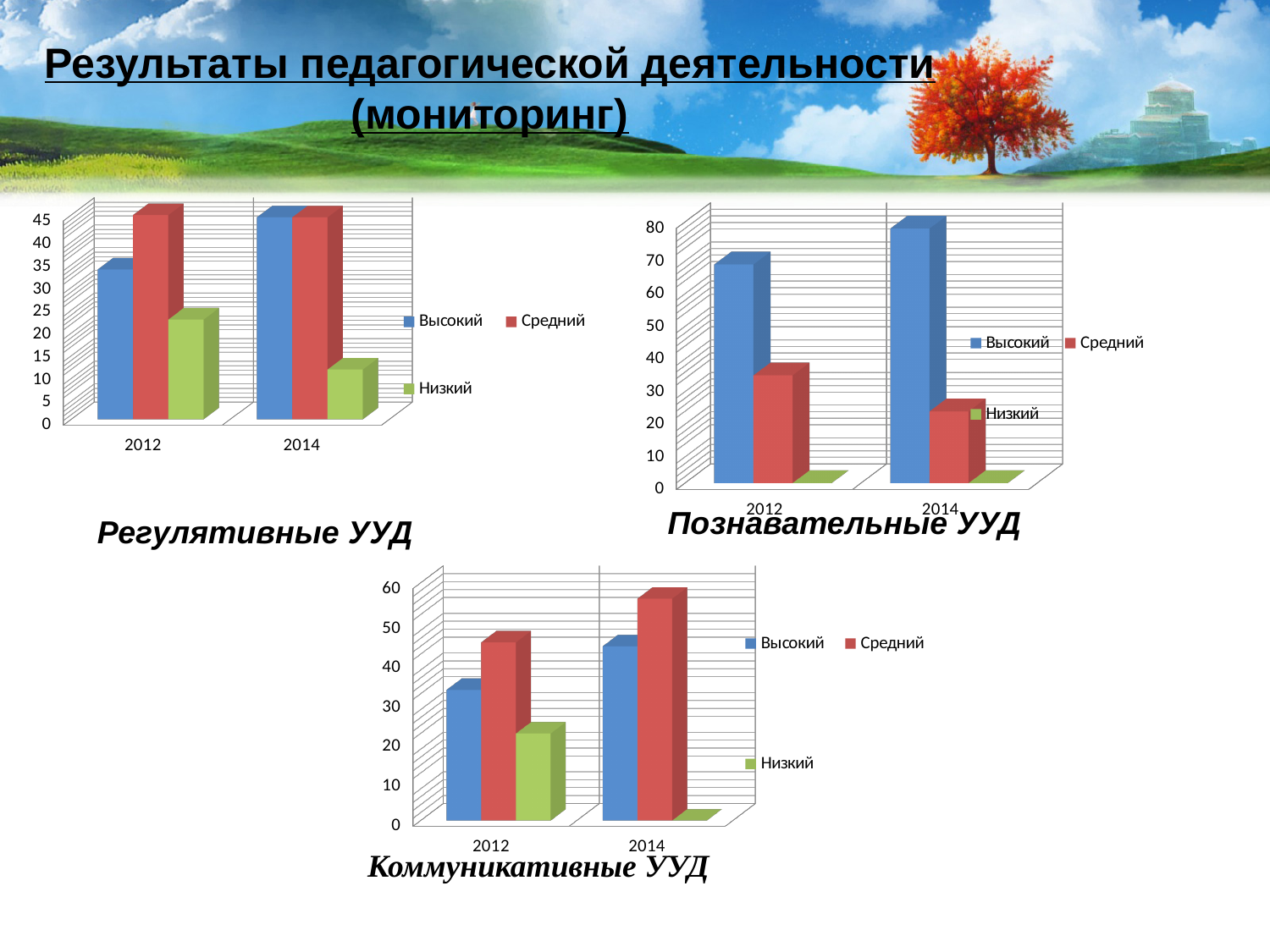
In the 'Познавательные УУД' chart, does the value for Высокий rise or fall from 2012 to 2014? rise In the 'Коммуникативные УУД' chart, is the value for Средний in 2014 greater or less than 50? greater What kind of chart is the 'Регулятивные УУД' chart? bar chart How many series does the legend of the 'Регулятивные УУД' chart list? 3 In the 'Коммуникативные УУД' chart, which series has the lowest value in 2014? Низкий In the 'Познавательные УУД' chart, is the value for Высокий in 2014 greater or less than 70? greater In the 'Регулятивные УУД' chart, does the value for Низкий rise or fall from 2012 to 2014? fall In the 'Регулятивные УУД' chart, is the value for Низкий in 2012 greater or less than 15? greater In the 'Познавательные УУД' chart, which series has the highest value in 2012? Высокий How many categories are shown on the x axis of the 'Познавательные УУД' chart? 2 In the 'Познавательные УУД' chart, is the value for Средний larger in 2012 or in 2014? 2012